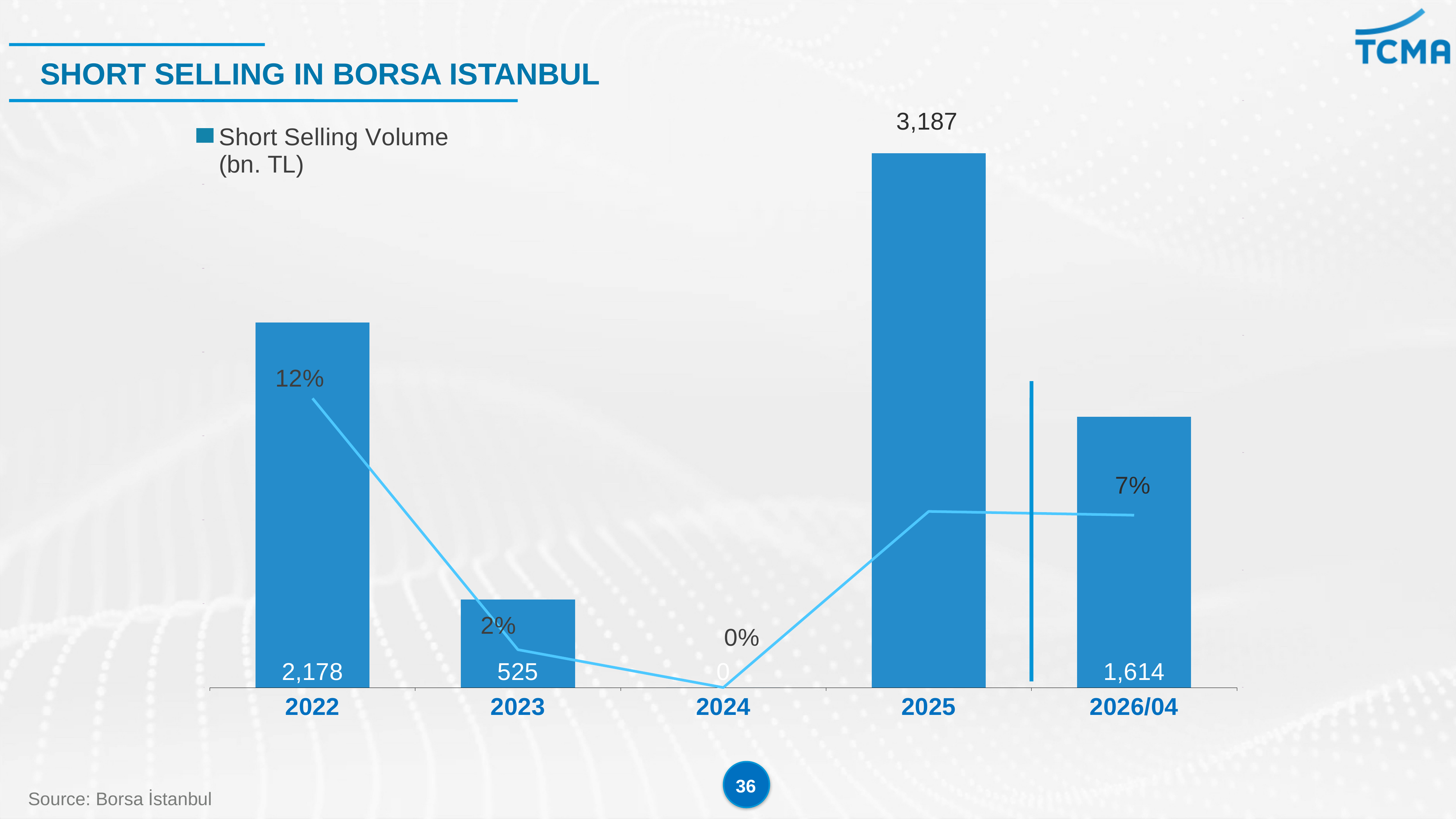
Which is larger, the Short Selling Volume for 2022 or for 2026/04? 2022 What percentage is shown on the line for 2022? 12% What is the difference in Short Selling Volume between 2025 and 2022? 1,009 What is the Short Selling Volume (bn. TL) for 2022? 2,178 What is the Short Selling Volume (bn. TL) for 2026/04? 1,614 What is the Short Selling Volume (bn. TL) for 2023? 525 Which year has the lowest Short Selling Volume? 2024 What kind of chart is shown on the slide? Bar chart with a line overlay What percentage is shown on the line for 2026/04? 7% Which year has the highest Short Selling Volume? 2025 How many categories are shown on the x axis? 5 What is the Short Selling Volume (bn. TL) for 2025? 3,187